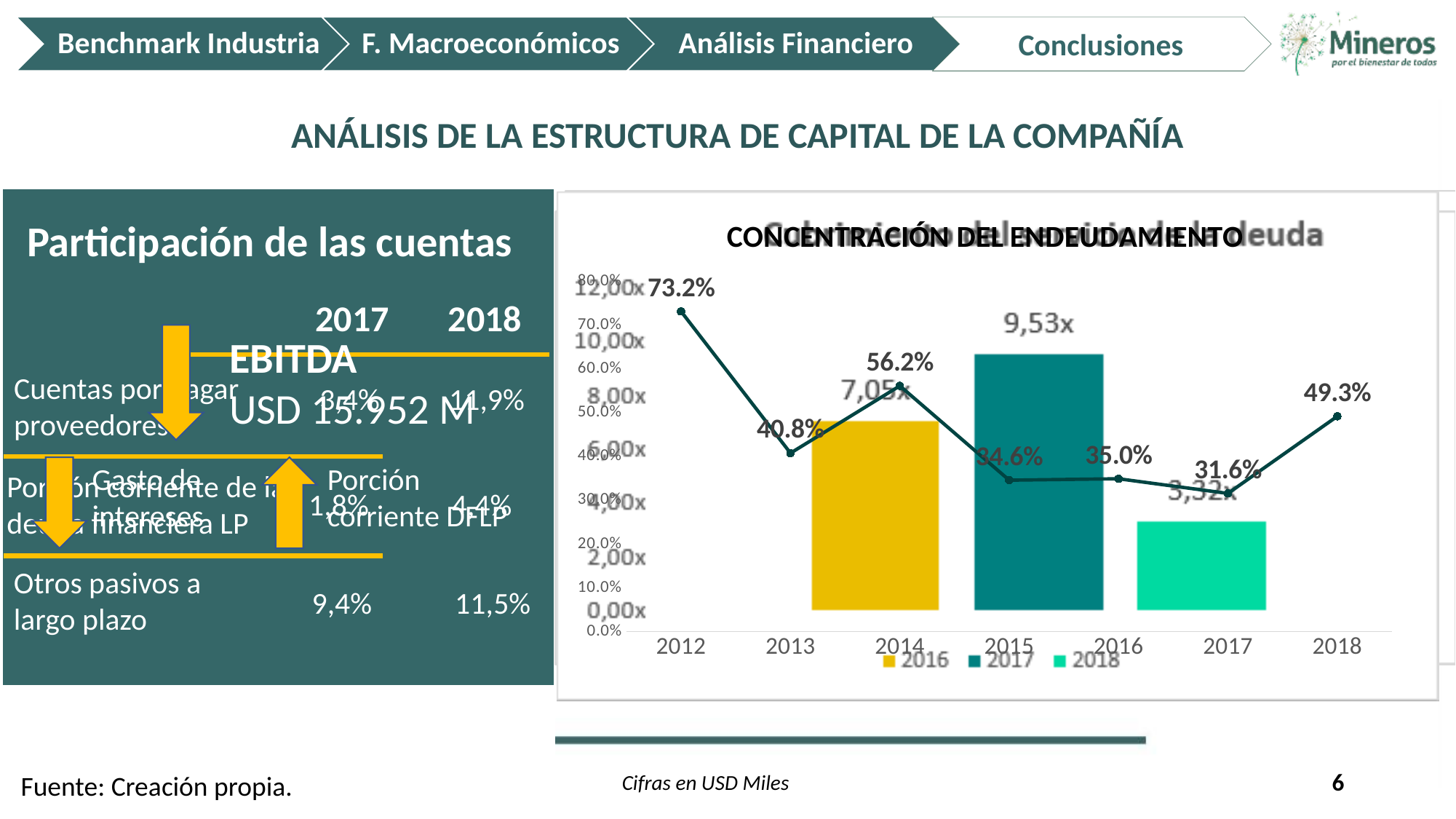
In the chart titled CONCENTRACIÓN DEL ENDEUDAMIENTO, how many years are plotted on the x axis? 7 In the chart titled CONCENTRACIÓN DEL ENDEUDAMIENTO, which year has the highest value? 2012 In the chart titled CONCENTRACIÓN DEL ENDEUDAMIENTO, what is the value for 2012? 73.2% In the bar chart behind the line chart on the right (legend 2016, 2017, 2018), what is the value of the 2017 bar? 9,53x What kind of chart is the one titled CONCENTRACIÓN DEL ENDEUDAMIENTO? line chart In the chart titled CONCENTRACIÓN DEL ENDEUDAMIENTO, does the value rise or fall from 2012 to 2013? fall In the chart titled CONCENTRACIÓN DEL ENDEUDAMIENTO, what is the difference between the 2012 value and the 2018 value? 23.9 percentage points In the chart titled CONCENTRACIÓN DEL ENDEUDAMIENTO, which year has the larger value, 2013 or 2014? 2014 In the chart titled CONCENTRACIÓN DEL ENDEUDAMIENTO, which year has the lowest value? 2017 In the chart titled CONCENTRACIÓN DEL ENDEUDAMIENTO, what is the value for 2018? 49.3% In the bar chart behind the line chart on the right (legend 2016, 2017, 2018), which year has the tallest bar? 2017 In the bar chart behind the line chart on the right, how many entries does the legend list? 3